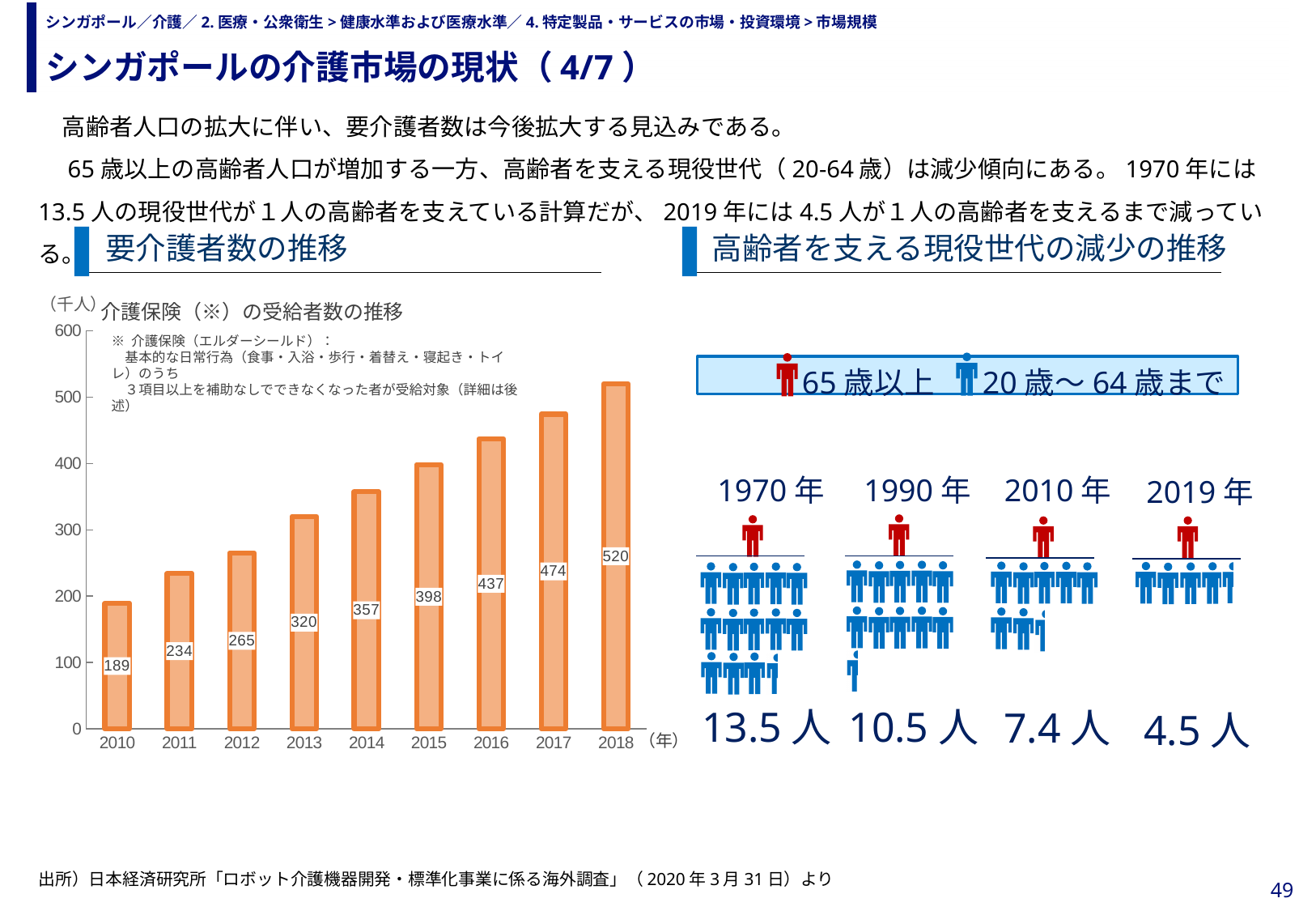
In the pictogram chart titled 高齢者を支える現役世代の減少の推移, what is the difference between the values for 1970年 and 2019年? 9人 In the bar chart titled 介護保険（※）の受給者数の推移, which is larger, the value for 2013 or the value for 2014? 2014 In the bar chart titled 介護保険（※）の受給者数の推移, what is the value for 2010? 189 In the bar chart titled 介護保険（※）の受給者数の推移, how many years are plotted? 9 In the bar chart titled 介護保険（※）の受給者数の推移, which year has the highest value? 2018 In the bar chart titled 介護保険（※）の受給者数の推移, which year has the lowest value? 2010 In the bar chart titled 介護保険（※）の受給者数の推移, what unit is shown on the vertical axis? 千人 In the bar chart titled 介護保険（※）の受給者数の推移, what is the value for 2015? 398 In the pictogram chart titled 高齢者を支える現役世代の減少の推移, what is the value for 1990年? 10.5人 In the bar chart titled 介護保険（※）の受給者数の推移, what is the difference between the values for 2018 and 2010? 331 In the bar chart titled 介護保険（※）の受給者数の推移, do the values rise or fall from 2010 to 2018? rise What kind of chart is the chart titled 介護保険（※）の受給者数の推移? bar chart